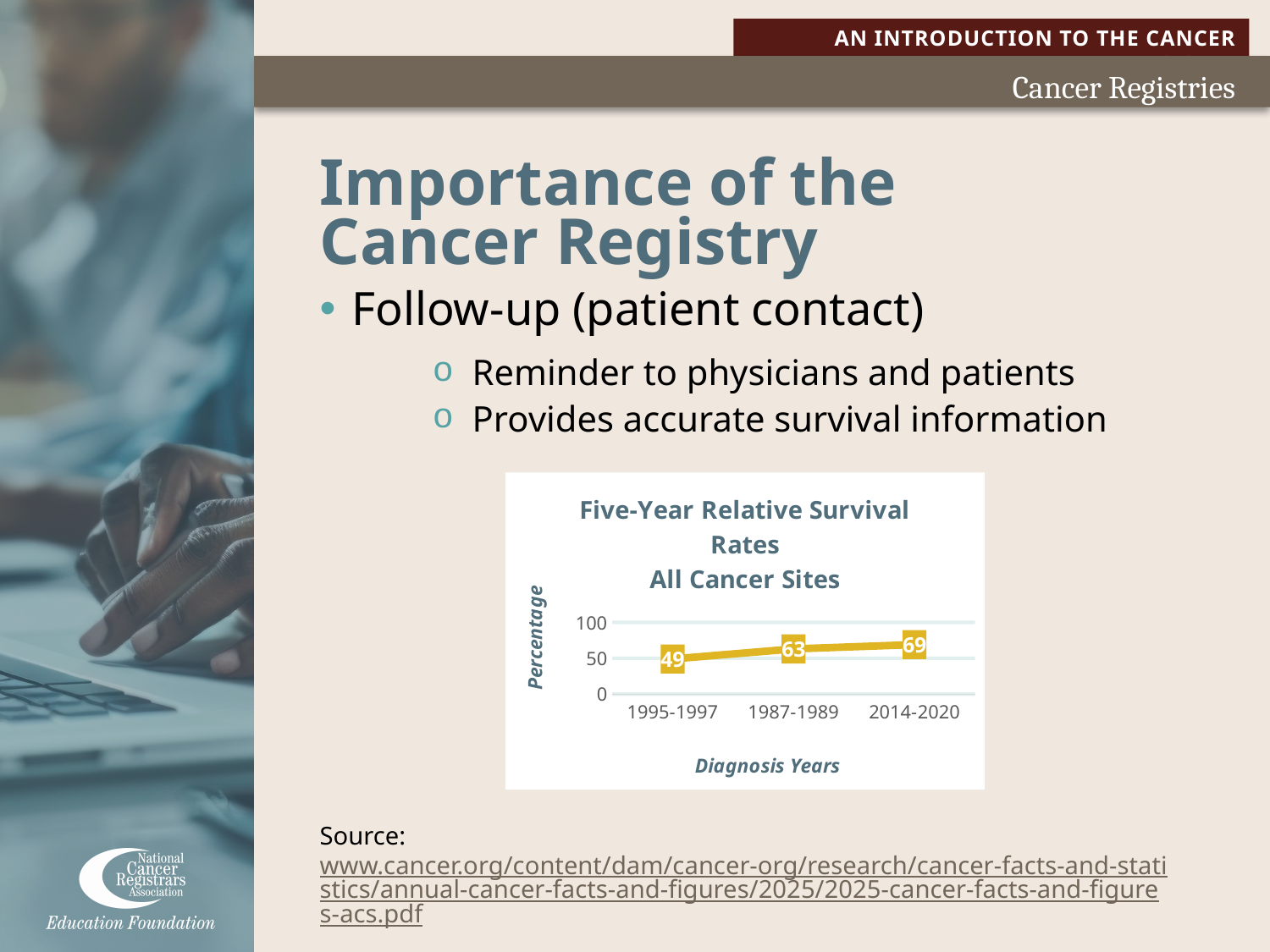
Which diagnosis years category has the highest survival rate? 2014-2020 What is the difference between the survival rate for 2014-2020 and for 1995-1997? 20 What is the five-year relative survival rate for the 1987-1989 diagnosis years? 63 What is the five-year relative survival rate for the 2014-2020 diagnosis years? 69 Is the value for 1995-1997 greater or less than 50? less Which diagnosis years category has the lowest survival rate? 1995-1997 What is the difference between the survival rate for 1987-1989 and for 1995-1997? 14 Which is larger, the survival rate for 1987-1989 or for 2014-2020? 2014-2020 How many diagnosis years categories are plotted on the x axis? 3 Do the values rise or fall from left to right along the x axis? rise What kind of chart is shown on the slide? line chart What is the five-year relative survival rate for the 1995-1997 diagnosis years? 49